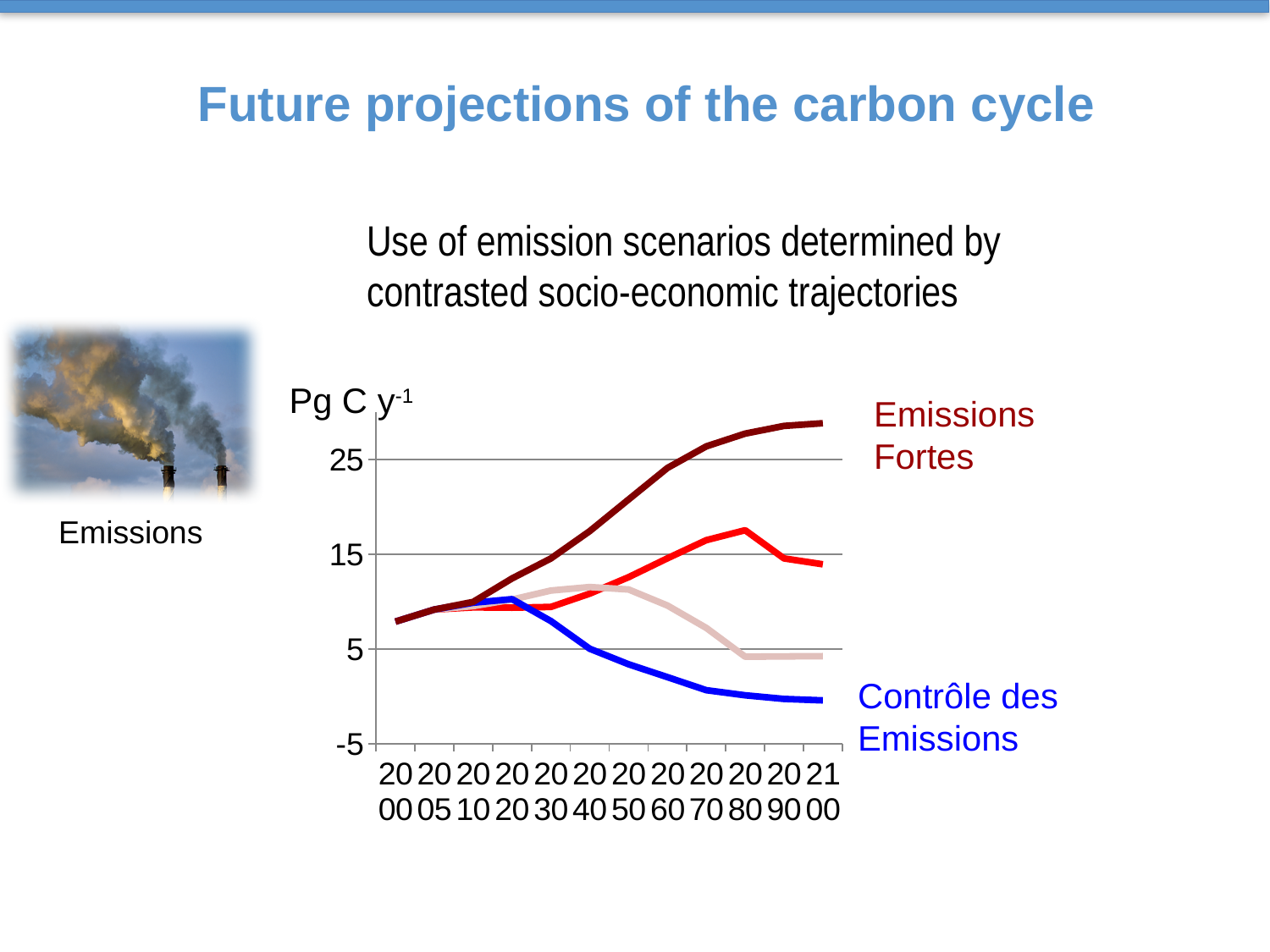
Is the value of the Contrôle des Emissions line in 2060 greater or less than 5? less Which scenario label is written next to the top line of the chart? Emissions Fortes Does the Emissions Fortes line rise or fall from 2000 to 2100? rise What unit is shown above the y axis of the chart? Pg C y-1 Is the value of the Emissions Fortes line in 2100 greater or less than 25? greater How many years are labelled along the x axis of the chart? 12 What kind of chart is shown on the slide? line chart Is the value of the Emissions Fortes line in 2050 greater or less than 15? greater How many lines are plotted on the chart? 4 Which line has the highest value in 2100? Emissions Fortes Which line has the lowest value in 2100? Contrôle des Emissions